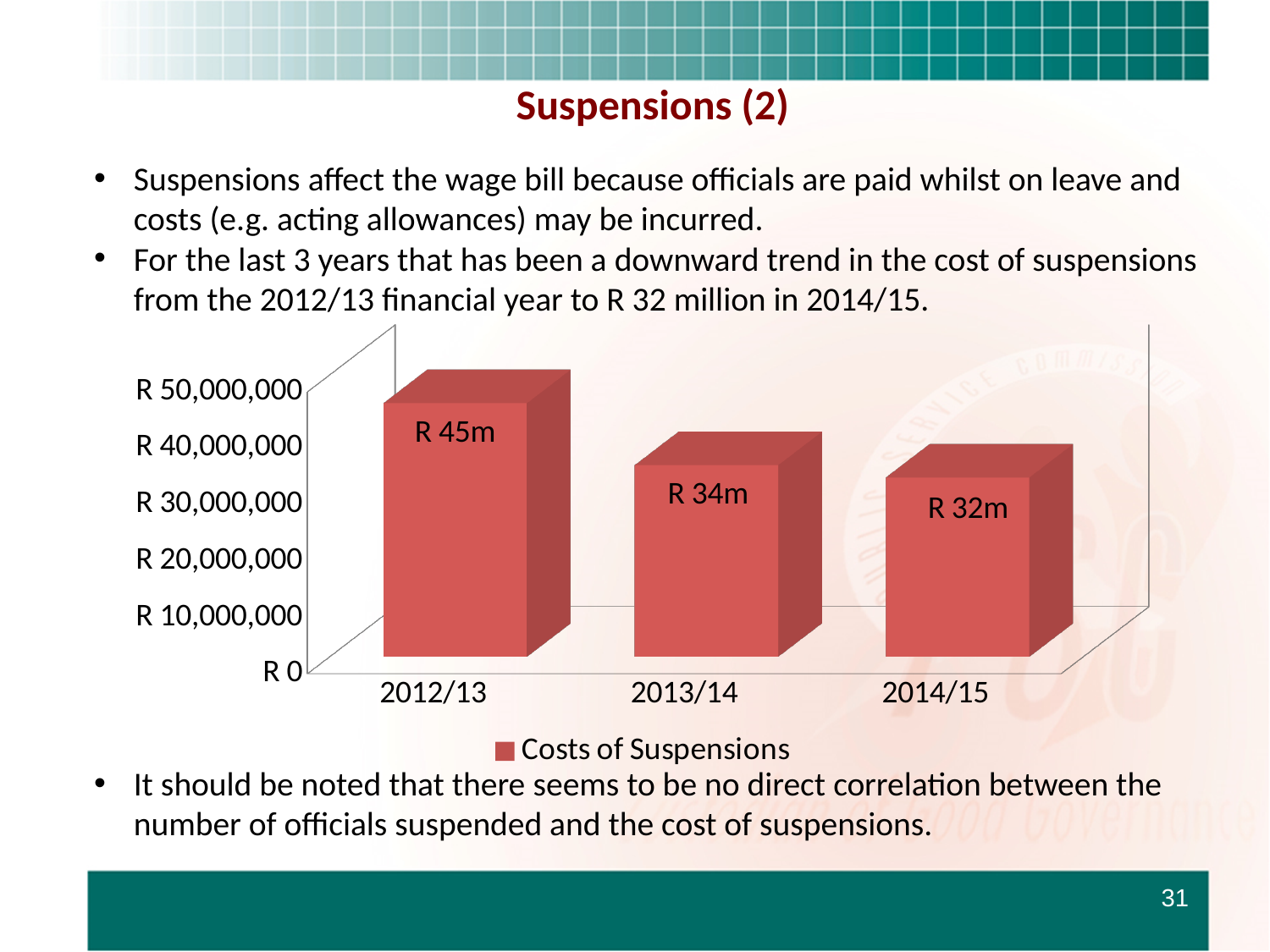
Which financial year has the lowest cost of suspensions? 2014/15 How many financial years are shown on the chart? 3 Which year has a higher cost of suspensions, 2012/13 or 2013/14? 2012/13 What is the difference in cost of suspensions between 2013/14 and 2014/15? R 2m Which financial year has the highest cost of suspensions? 2012/13 What is the cost of suspensions for 2012/13? R 45m What kind of chart is shown on the slide? Bar chart How many series does the legend list? 1 What is the difference in cost of suspensions between 2012/13 and 2014/15? R 13m What is the cost of suspensions for 2014/15? R 32m What is the cost of suspensions for 2013/14? R 34m Do the costs of suspensions rise or fall from 2012/13 to 2014/15? Fall